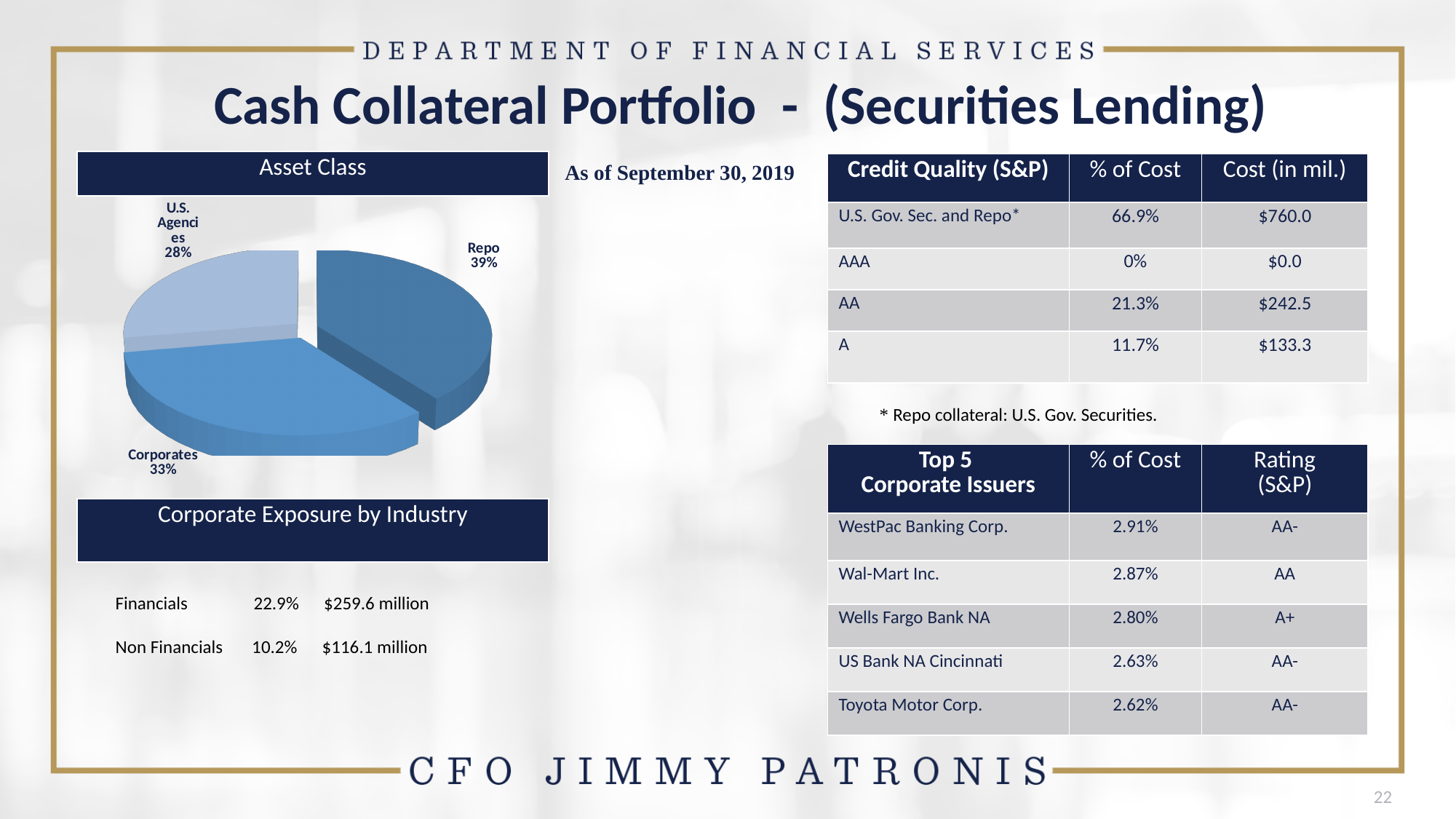
In the Asset Class pie chart, what share does Corporates represent? 33% What is the title of the pie chart on the slide? Asset Class In the Asset Class pie chart, what share does U.S. Agencies represent? 28% In the Asset Class pie chart, what share does Repo represent? 39% In the Asset Class pie chart, what is the combined share of Corporates and U.S. Agencies? 61% In the Asset Class pie chart, which is larger: Corporates or U.S. Agencies? Corporates In the Asset Class pie chart, how many percentage points larger is Repo than Corporates? 6 Which asset class has the largest slice in the Asset Class pie chart? Repo How many slices does the Asset Class pie chart have? 3 In the Asset Class pie chart, how many percentage points larger is Repo than U.S. Agencies? 11 Which asset class has the smallest slice in the Asset Class pie chart? U.S. Agencies What type of chart is shown under the "Asset Class" heading? Pie chart